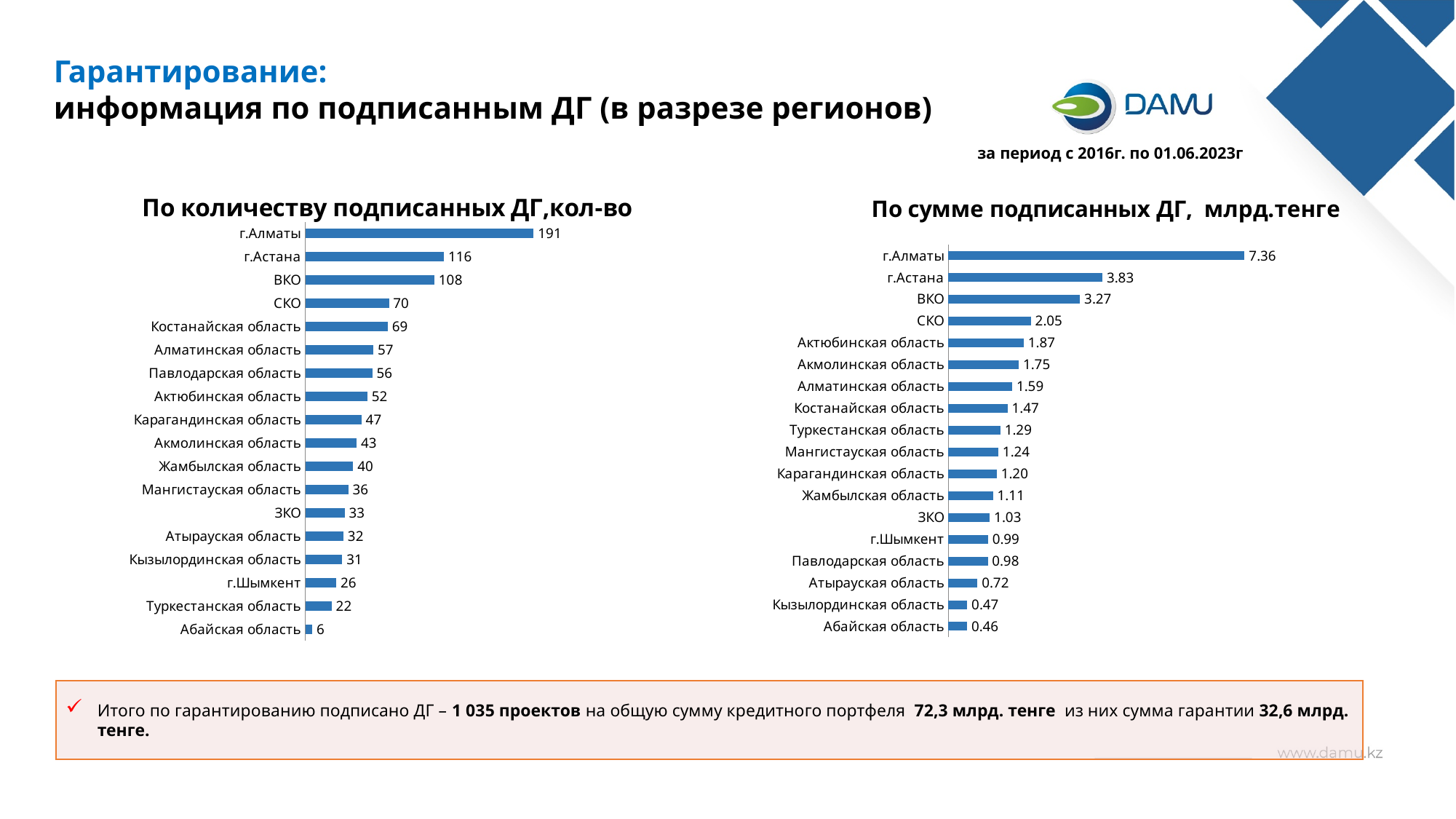
What kind of chart is 'По сумме подписанных ДГ, млрд.тенге'? Bar chart In the chart 'По количеству подписанных ДГ,кол-во', which region has the highest value? г.Алматы In the chart 'По сумме подписанных ДГ, млрд.тенге', which region has the lowest value? Абайская область What period do the charts on the slide cover? с 2016г. по 01.06.2023г In the chart 'По количеству подписанных ДГ,кол-во', which is larger: Павлодарская область or Актюбинская область? Павлодарская область In the chart 'По количеству подписанных ДГ,кол-во', what is the value for г.Астана? 116 How many regions are shown in the chart 'По количеству подписанных ДГ,кол-во'? 18 In the chart 'По сумме подписанных ДГ, млрд.тенге', what is the difference between г.Алматы and г.Астана? 3.53 In the chart 'По сумме подписанных ДГ, млрд.тенге', what is the value for Туркестанская область? 1.29 In the chart 'По количеству подписанных ДГ,кол-во', what is the difference between г.Алматы and ВКО? 83 In the chart 'По количеству подписанных ДГ,кол-во', what is the value for Абайская область? 6 In the chart 'По сумме подписанных ДГ, млрд.тенге', which is larger: Павлодарская область or Актюбинская область? Актюбинская область